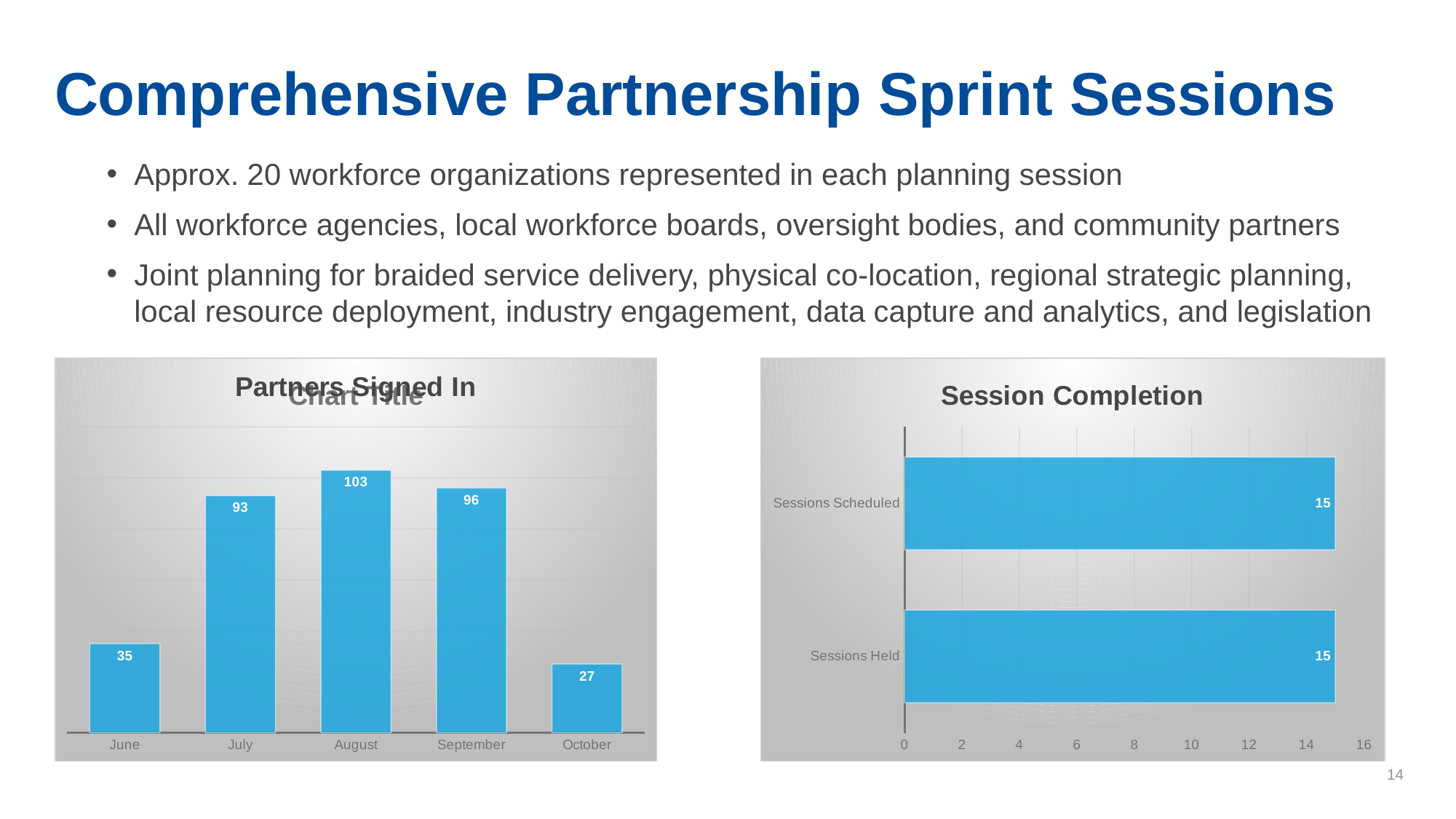
In the Session Completion chart, is the value for Sessions Scheduled greater or less than 10? greater How many months are shown in the Partners Signed In chart? 5 In the Partners Signed In chart, what is the value for June? 35 In the Session Completion chart, what is the difference between Sessions Scheduled and Sessions Held? 0 In the Session Completion chart, what is the value for Sessions Held? 15 In the Partners Signed In chart, which month has the highest value? August What kind of chart is the Partners Signed In chart? Bar chart How many categories are shown in the Session Completion chart? 2 In the Partners Signed In chart, what is the value for August? 103 In the Partners Signed In chart, which month has the lowest value? October In the Partners Signed In chart, what is the difference between the values for August and July? 10 In the Partners Signed In chart, which is larger, the value for July or the value for September? September